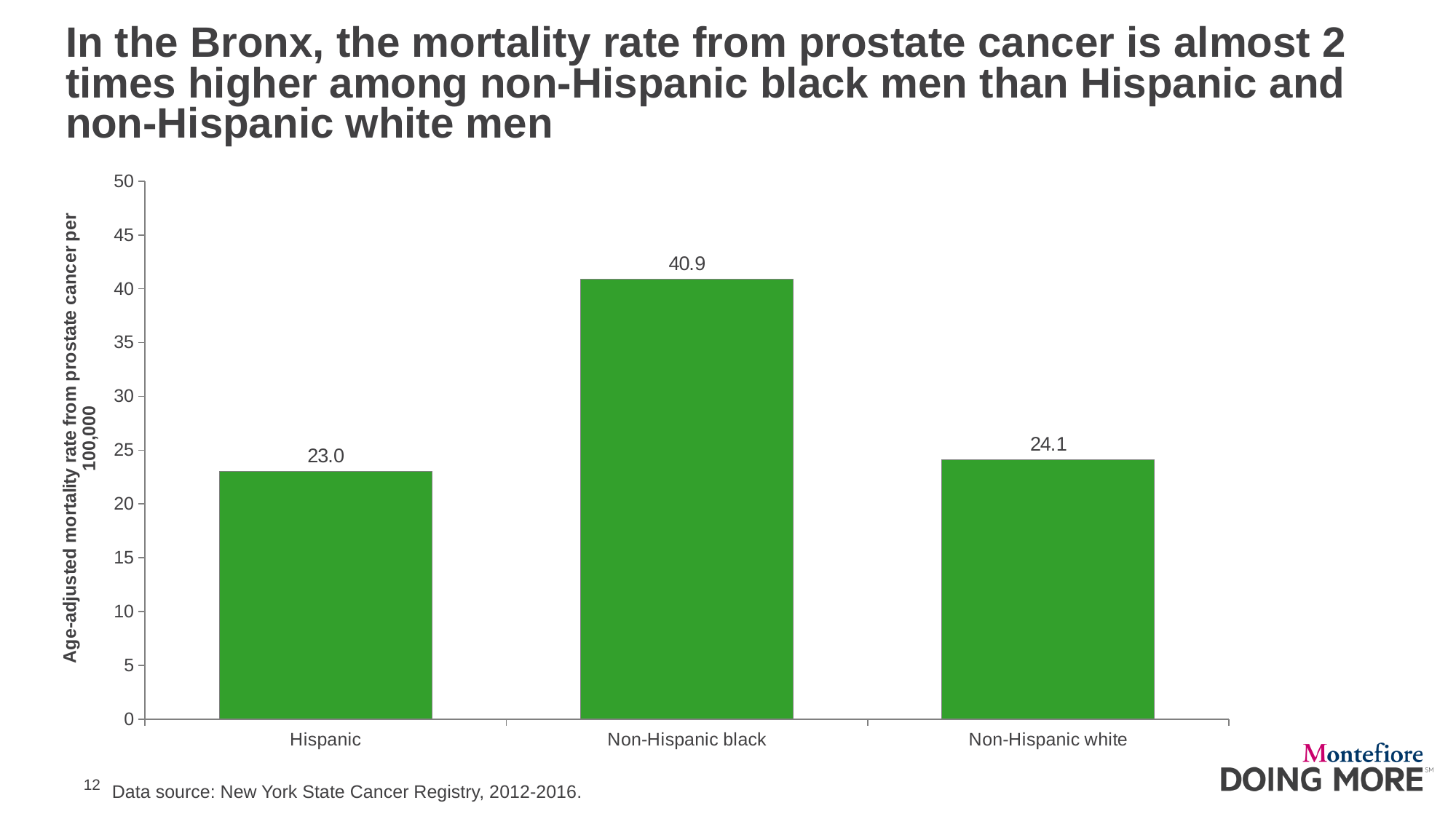
What is the age-adjusted prostate cancer mortality rate per 100,000 for non-Hispanic black men? 40.9 What is the age-adjusted prostate cancer mortality rate per 100,000 for Hispanic men? 23.0 Which group has the lowest prostate cancer mortality rate? Hispanic Which is larger, the mortality rate for non-Hispanic black men or for non-Hispanic white men? Non-Hispanic black What kind of chart is shown on the slide? Bar chart What is the difference between the mortality rates for non-Hispanic black men and Hispanic men? 17.9 Which group has the highest prostate cancer mortality rate? Non-Hispanic black What is the age-adjusted prostate cancer mortality rate per 100,000 for non-Hispanic white men? 24.1 Is the mortality rate for non-Hispanic black men greater or less than 35? greater What is the difference between the mortality rates for non-Hispanic black men and non-Hispanic white men? 16.8 What is the label of the vertical axis? Age-adjusted mortality rate from prostate cancer per 100,000 How many groups are shown in the chart? 3